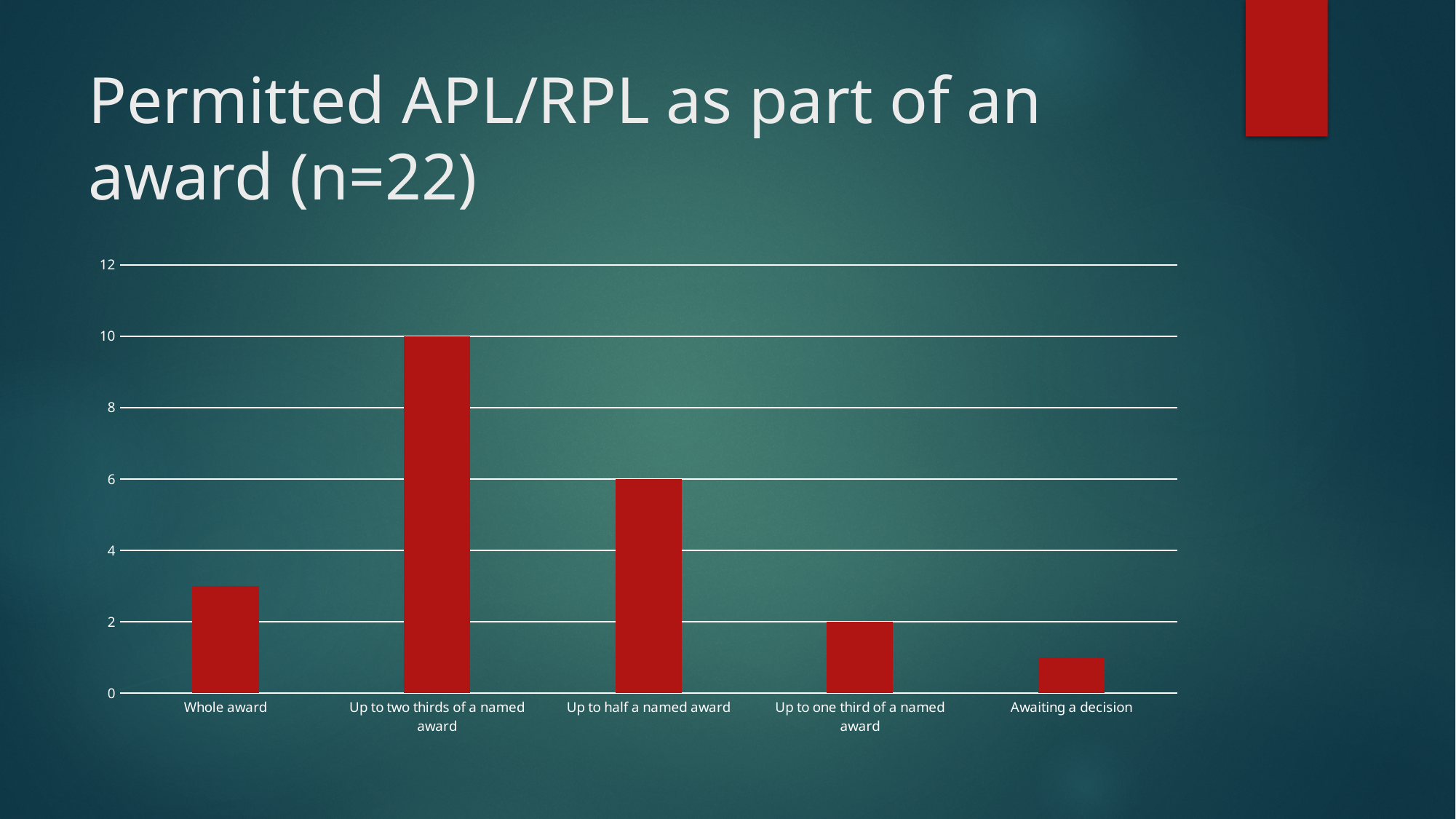
What is the difference between the values for 'Up to two thirds of a named award' and 'Up to half a named award'? 4 Which is larger, the value for 'Whole award' or the value for 'Up to half a named award'? Up to half a named award Is the value for 'Whole award' greater or less than 4? less What is the value for 'Up to two thirds of a named award'? 10 Is the value for 'Awaiting a decision' greater or less than 2? less What type of chart is shown on the slide? Bar chart What is the title of the slide containing the chart? Permitted APL/RPL as part of an award (n=22) Which category has the lowest value in the chart? Awaiting a decision Which category has the highest value in the chart? Up to two thirds of a named award How many categories are shown on the x axis of the chart? 5 What is the value for 'Up to one third of a named award'? 2 What is the value for 'Up to half a named award'? 6